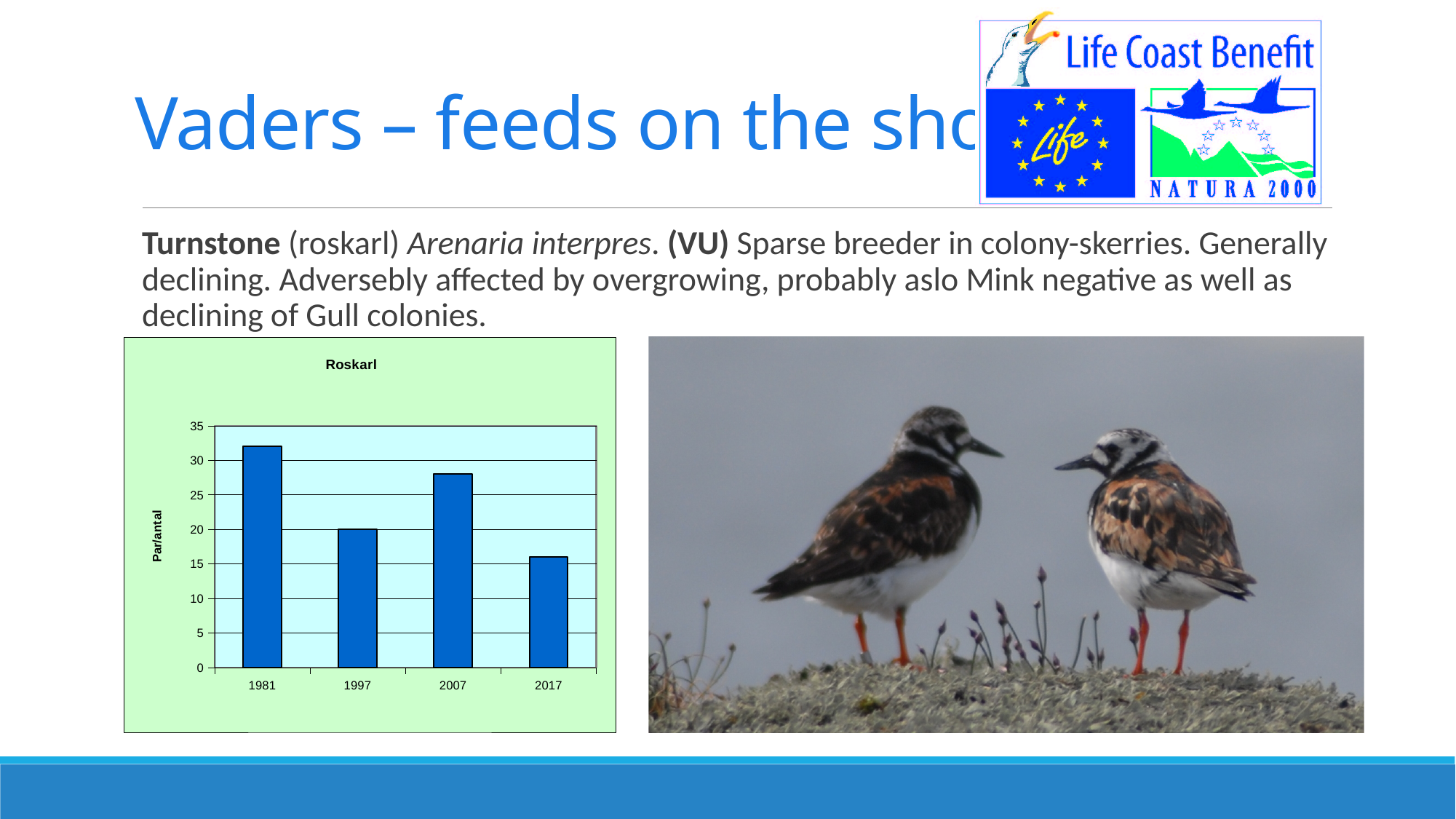
What kind of chart is shown on the slide? bar chart How many years are shown on the x axis of the chart? 4 What is the value for 1997 in the chart? 20 What is the title of the chart? Roskarl Is the value for 1981 greater or less than 30? greater Which year has the highest value in the chart? 1981 Which is larger, the value for 1981 or the value for 2007? 1981 Is the value for 2007 greater or less than 25? greater Does the value rise or fall from 2007 to 2017? fall Which year has the lowest value in the chart? 2017 Is the value for 2017 greater or less than 20? less What is the label on the vertical axis of the chart? Par/antal